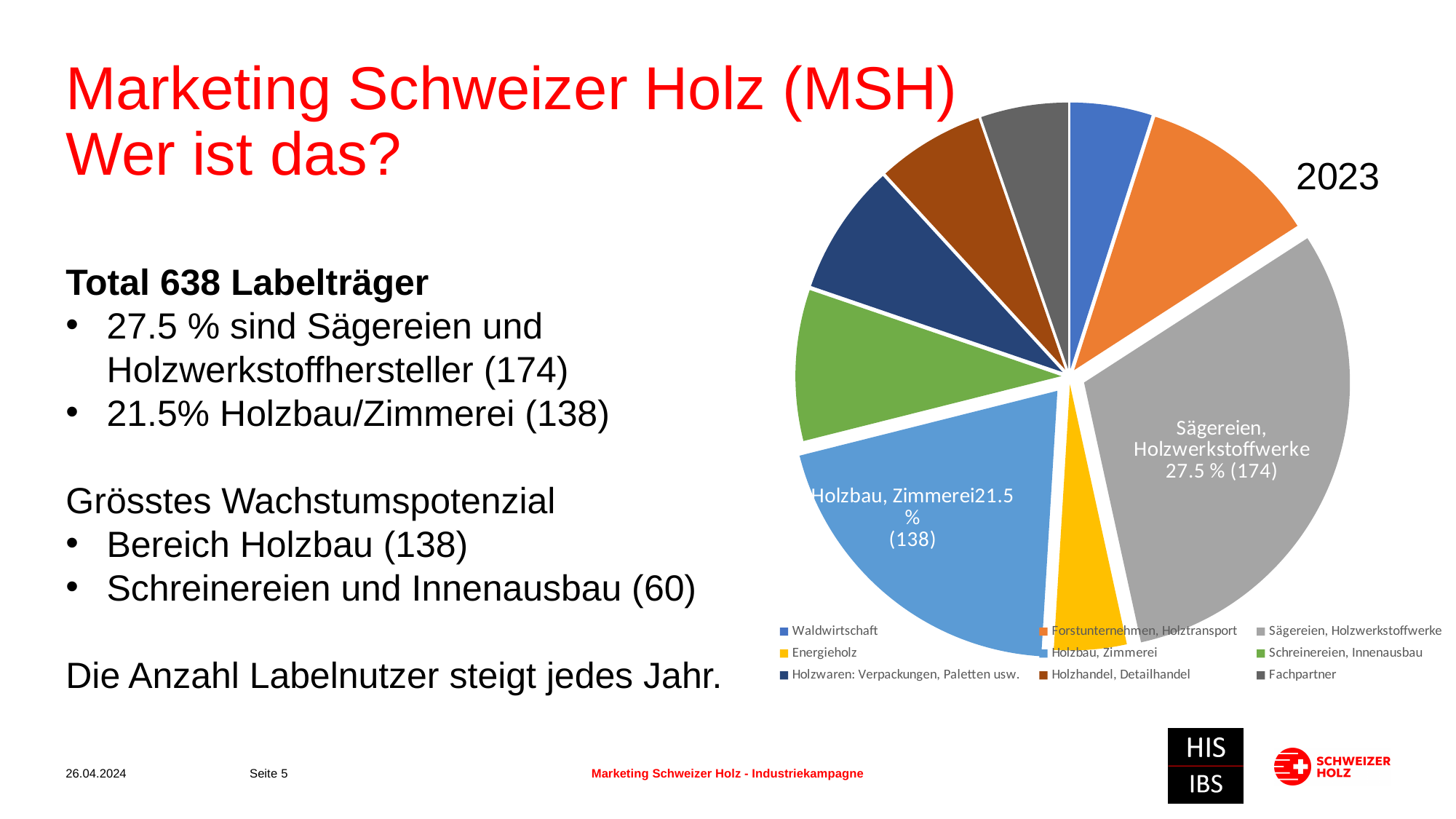
What share of the pie does Sägereien, Holzwerkstoffwerke hold? 27.5 % How many categories does the legend of the pie chart list? 9 What is the difference between the values for Sägereien, Holzwerkstoffwerke and Holzbau, Zimmerei? 36 What colour is the Energieholz slice in the pie chart? yellow How many slices does the pie chart have? 9 What is the number shown for Holzbau, Zimmerei in the pie chart? 138 What is the number shown for Sägereien, Holzwerkstoffwerke in the pie chart? 174 Which slice is larger: Holzbau, Zimmerei or Schreinereien, Innenausbau? Holzbau, Zimmerei What share of the pie does Holzbau, Zimmerei hold? 21.5 % Which category has the largest slice in the pie chart? Sägereien, Holzwerkstoffwerke What kind of chart is shown on the slide? pie chart Which year is labelled next to the pie chart? 2023